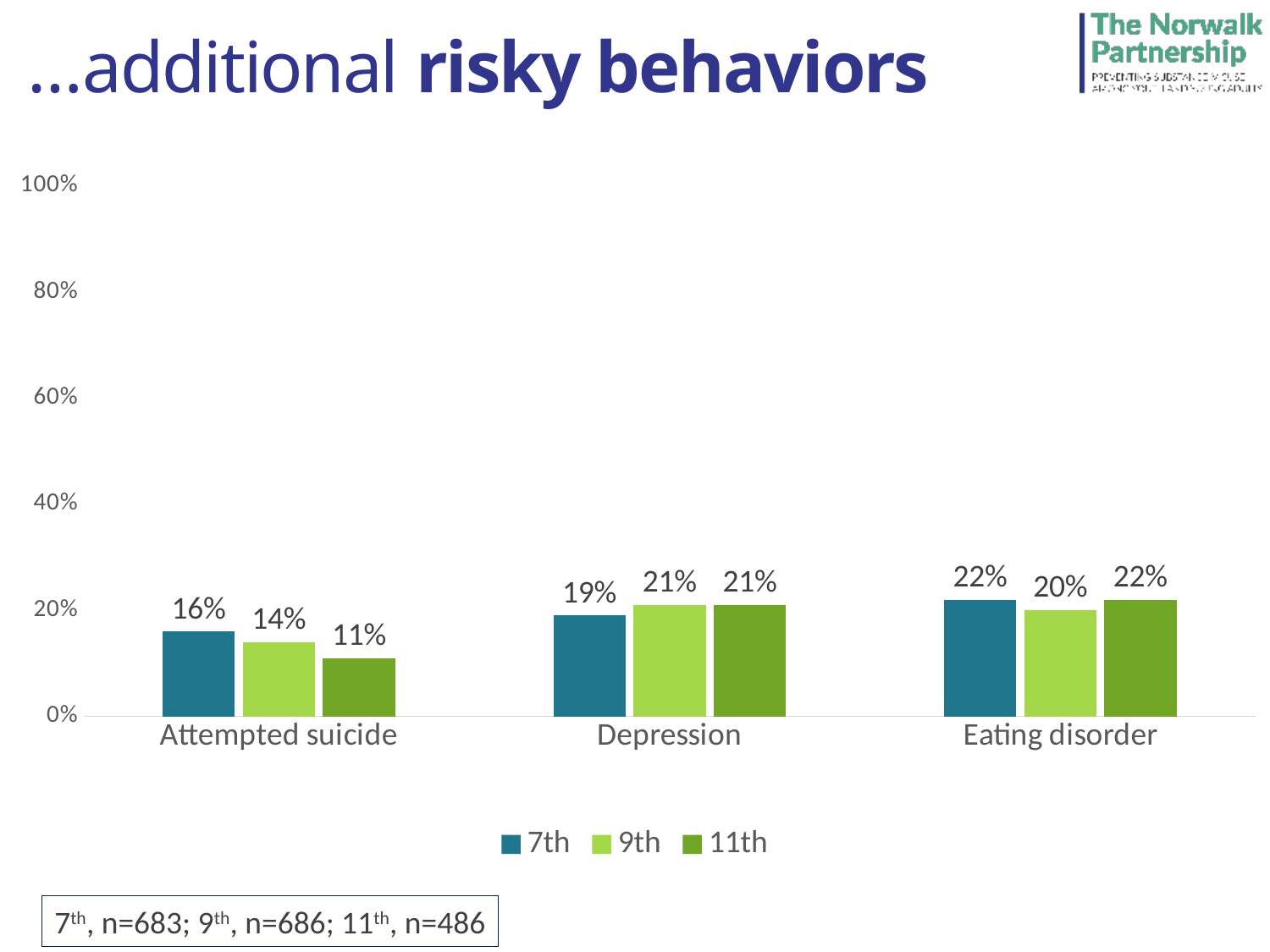
How many series does the legend list? 3 What is the difference between the 7th and 11th grade values for Attempted suicide? 5% What is the value for 9th graders for Eating disorder? 20% Is the value for 9th graders for Depression greater or less than 40%? less Which is larger for Eating disorder: the 7th grade value or the 9th grade value? 7th How many categories are shown on the x axis? 3 What is the value for 7th graders for Attempted suicide? 16% Which grade has the lowest value for Depression? 7th What are the series names listed in the legend? 7th, 9th, 11th Which grade has the lowest value for Attempted suicide? 11th What is the value for 11th graders for Depression? 21% What kind of chart is shown on the slide? bar chart